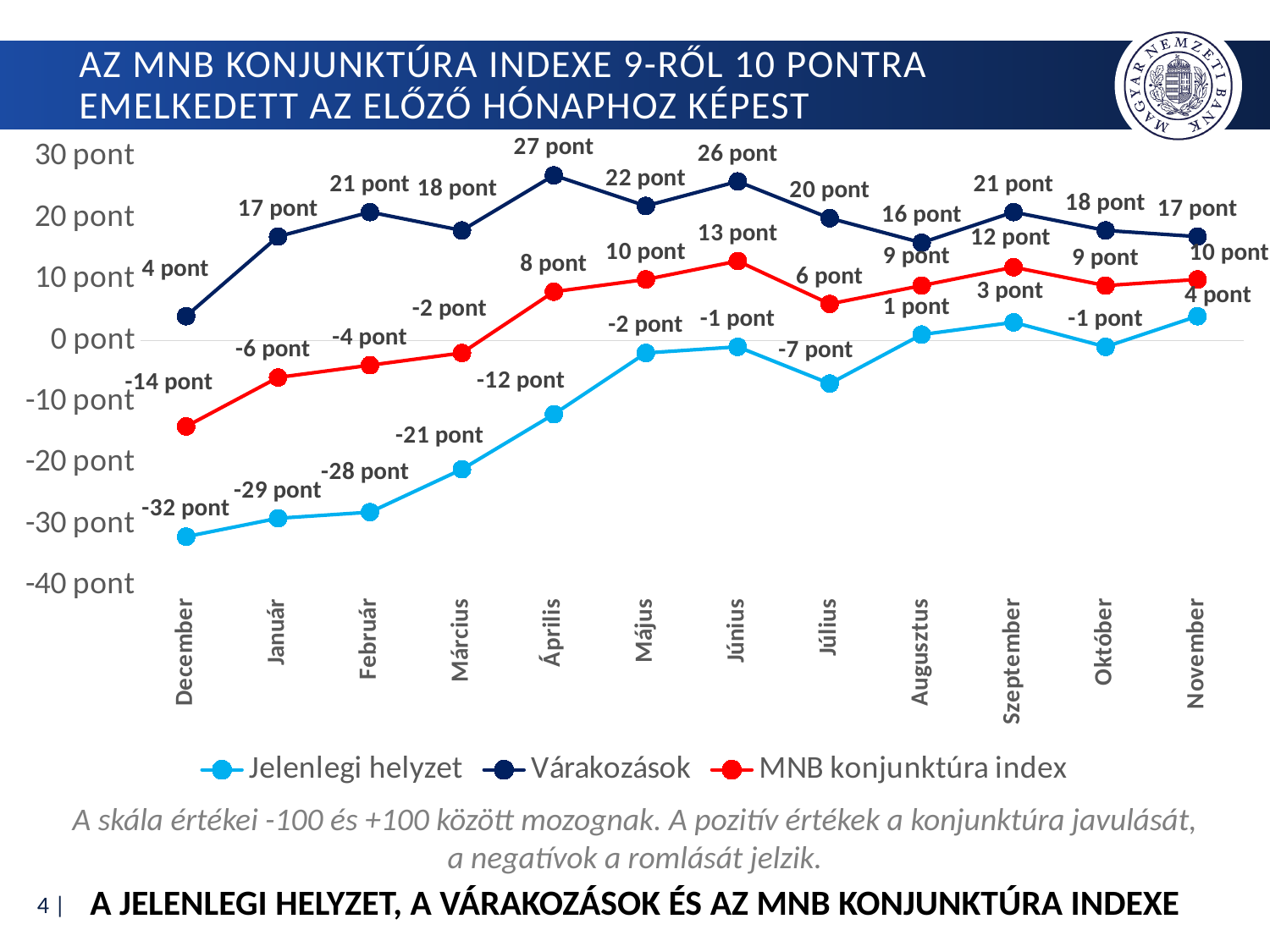
What is the difference between the MNB konjunktúra index in Június and in Július? 7 pont Which is larger in Szeptember: Várakozások or MNB konjunktúra index? Várakozások What is the value of MNB konjunktúra index in November? 10 pont How many series does the legend list? 3 Is the value of Jelenlegi helyzet in Március greater or less than -20 pont? less In which month is Várakozások highest? Április What is the value of Várakozások in Április? 27 pont Does Jelenlegi helyzet rise or fall from December to Június? rise What is the value of Jelenlegi helyzet in December? -32 pont What kind of chart is shown on the slide? line chart How many months are shown on the x axis? 12 In which month is Jelenlegi helyzet lowest? December